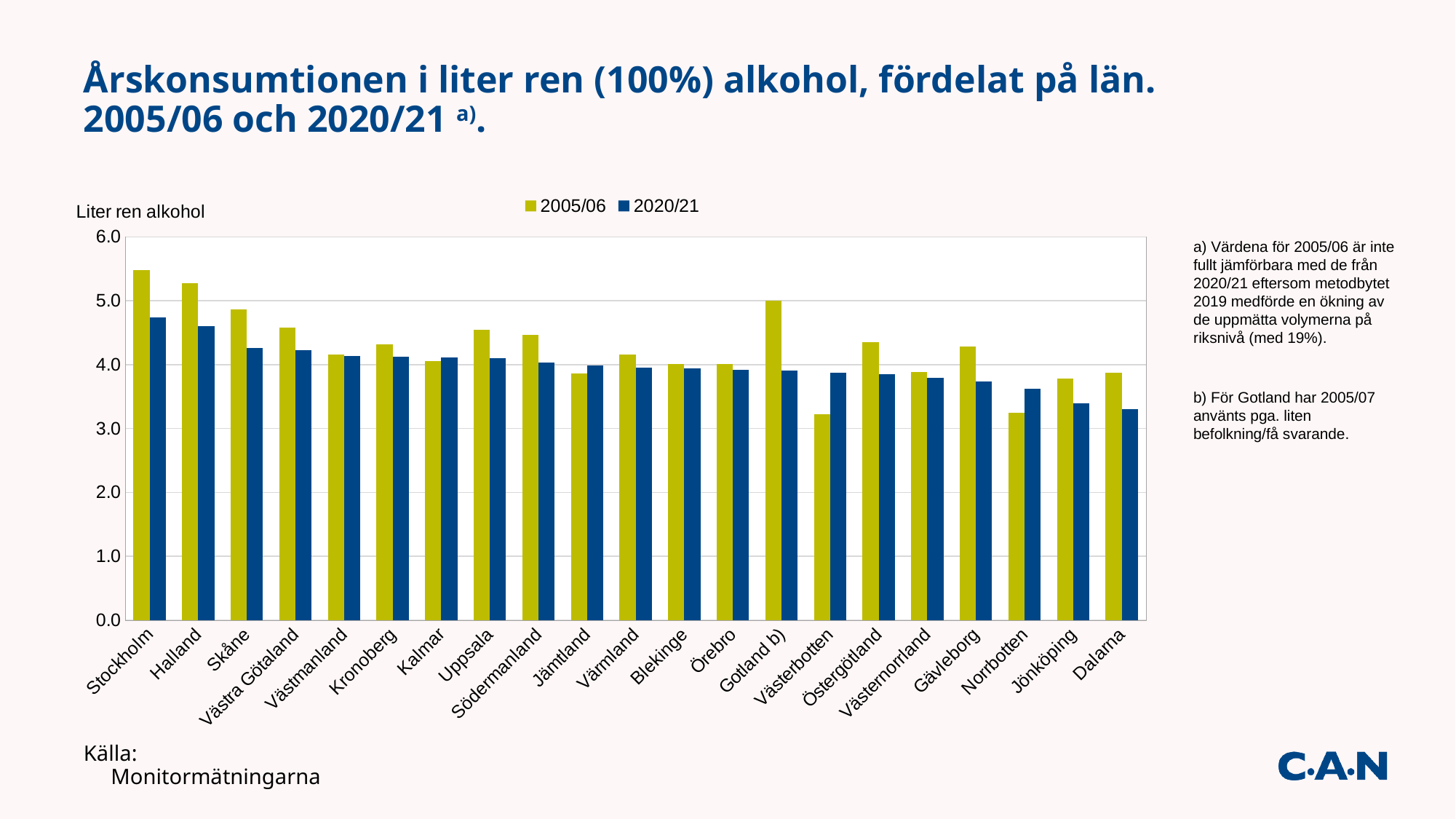
For Gotland b), which series has the larger value, 2005/06 or 2020/21? 2005/06 What kind of chart is shown on the slide? Bar chart Which county has the highest value for 2005/06? Stockholm Is the 2005/06 value for Västerbotten greater or less than 4.0? less Is the 2020/21 value for Stockholm greater or less than 4.0? greater What is the label on the y axis of the chart? Liter ren alkohol How many series does the legend list? 2 How many counties (län) are shown on the x axis? 21 For Västerbotten, which series has the larger value, 2005/06 or 2020/21? 2020/21 Which county has the highest value for 2020/21? Stockholm Is the 2020/21 value for Dalarna greater or less than 4.0? less